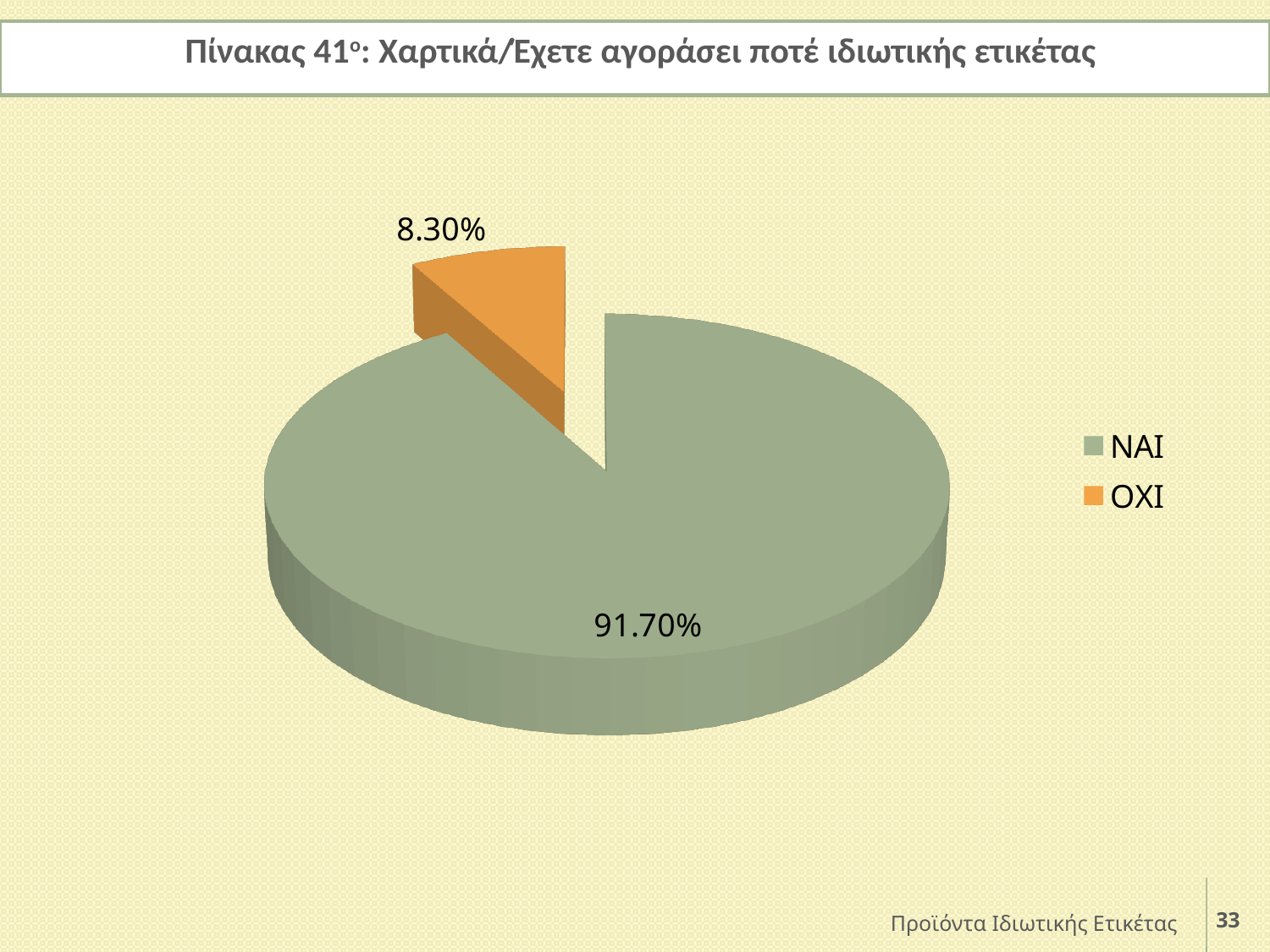
Which category has the largest share of the pie? ΝΑΙ What kind of chart is shown on the slide? Pie chart What is the title of the chart? Πίνακας 41ο: Χαρτικά/Έχετε αγοράσει ποτέ ιδιωτικής ετικέτας Which category has the smallest share of the pie? ΟΧΙ What share of the pie does the ΟΧΙ slice represent? 8.30% Which is larger, the value for ΝΑΙ or the value for ΟΧΙ? ΝΑΙ What is the value for ΟΧΙ? 8.30% How many entries does the legend list? 2 How many slices does the pie chart have? 2 What is the difference between the ΝΑΙ and ΟΧΙ values? 83.40% What colour is the ΟΧΙ slice? Orange What is the value for ΝΑΙ? 91.70%